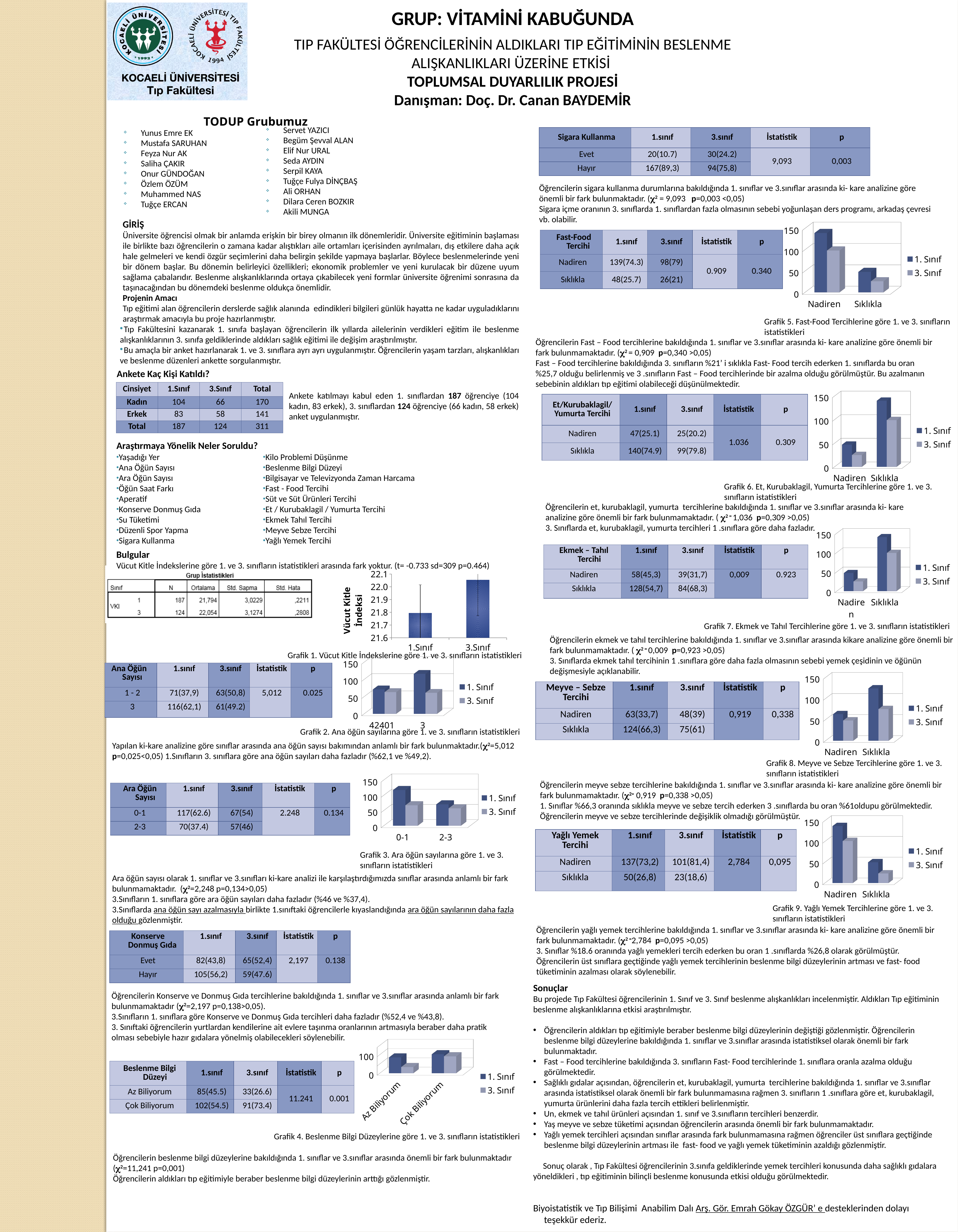
In Grafik 3 (Ara öğün sayıları), is the value for 1. Sınıf in the 0-1 category greater or less than 100? greater In Grafik 8 (Meyve ve Sebze Tercihleri), which is larger in the Nadiren category: 1. Sınıf or 3. Sınıf? 1. Sınıf In Grafik 7 (Ekmek ve Tahıl Tercihleri), which is larger in the Sıklıkla category: 1. Sınıf or 3. Sınıf? 1. Sınıf How many series does the legend of Grafik 5 (Fast-Food Tercihleri) list? 2 In Grafik 9 (Yağlı Yemek Tercihleri), which category has the lowest 3. Sınıf bar? Sıklıkla In Grafik 1 (Vücut Kitle İndeksi), does the value rise or fall from 1.Sınıf to 3.Sınıf? rise In Grafik 6 (Et, Kurubaklagil, Yumurta Tercihleri), which category has the highest 1. Sınıf bar? Sıklıkla In Grafik 5 (Fast-Food Tercihleri), is the value for 3. Sınıf in the Sıklıkla category greater or less than 50? less In Grafik 6 (Et, Kurubaklagil, Yumurta Tercihleri), is the value for 1. Sınıf in the Sıklıkla category greater or less than 100? greater What kind of chart is Grafik 1 (Vücut Kitle İndeksi)? bar chart